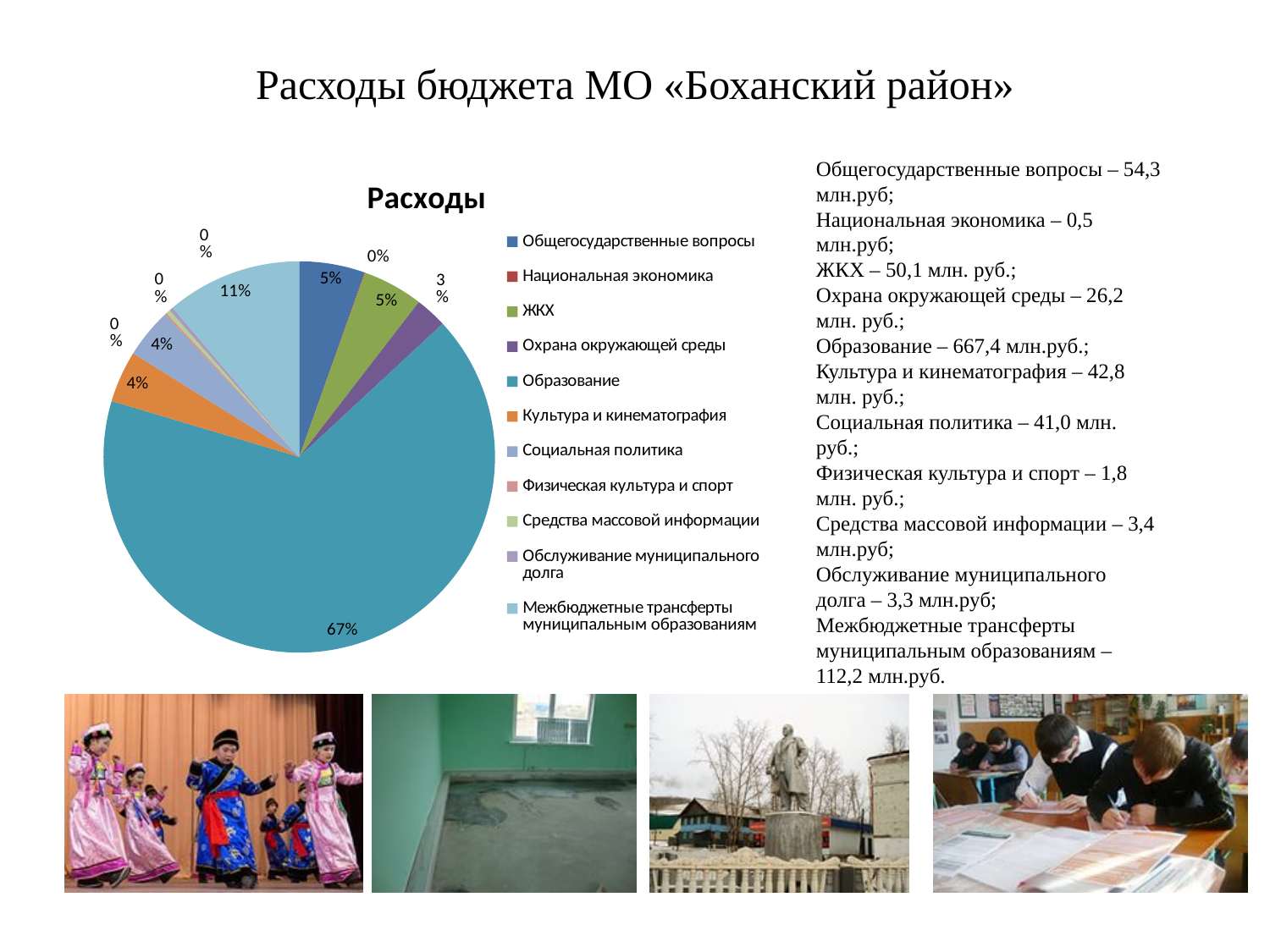
What is the data label for ЖКХ? 5% What is the title of the chart? Расходы Which is larger, the share for Образование or the share for Межбюджетные трансферты муниципальным образованиям? Образование Which category has the largest share of the pie? Образование What share of the pie does Межбюджетные трансферты муниципальным образованиям have? 11% What kind of chart is shown on the slide? pie chart How many entries does the chart legend list? 11 What is the data label for Охрана окружающей среды? 3% What share of the pie does Образование have? 67% What colour is the slice for Образование? teal What is the data label for Культура и кинематография? 4% What is the difference in percentage points between the share for Образование and the share for Межбюджетные трансферты муниципальным образованиям? 56